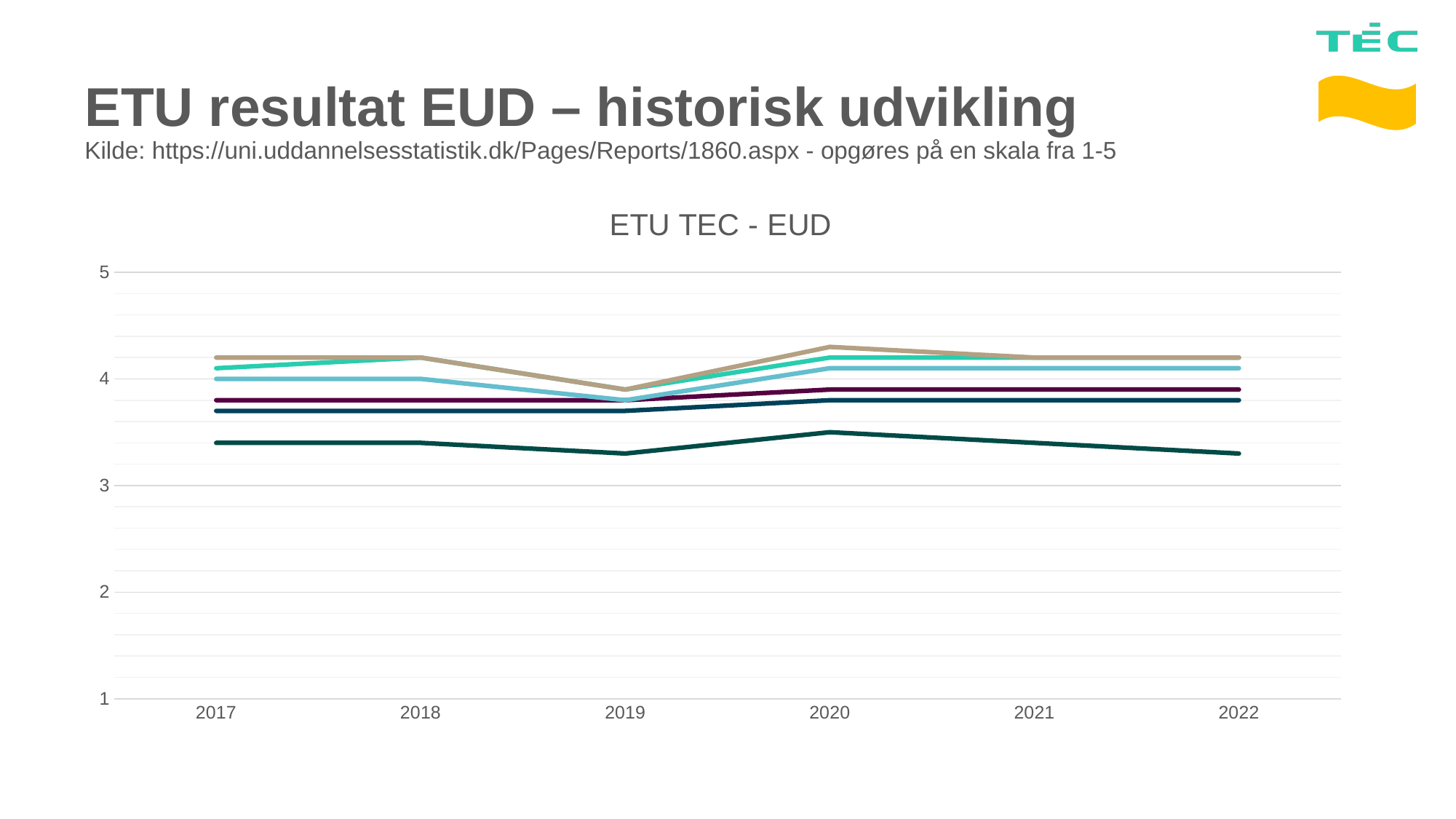
Is the value of the highest line in 2020 greater or less than 4? greater For the highest line, is the value larger in 2019 or in 2020? 2020 Does the lowest line rise or fall from 2020 to 2022? fall How many lines are plotted in the chart? 6 Is the value of the lowest line in 2022 greater or less than 4? less What is the title of the chart? ETU TEC - EUD What kind of chart is shown on the slide? line chart How many years are shown on the x axis of the chart? 6 Is the value of the lowest line in 2019 greater or less than 3? greater What is the first year shown on the x axis? 2017